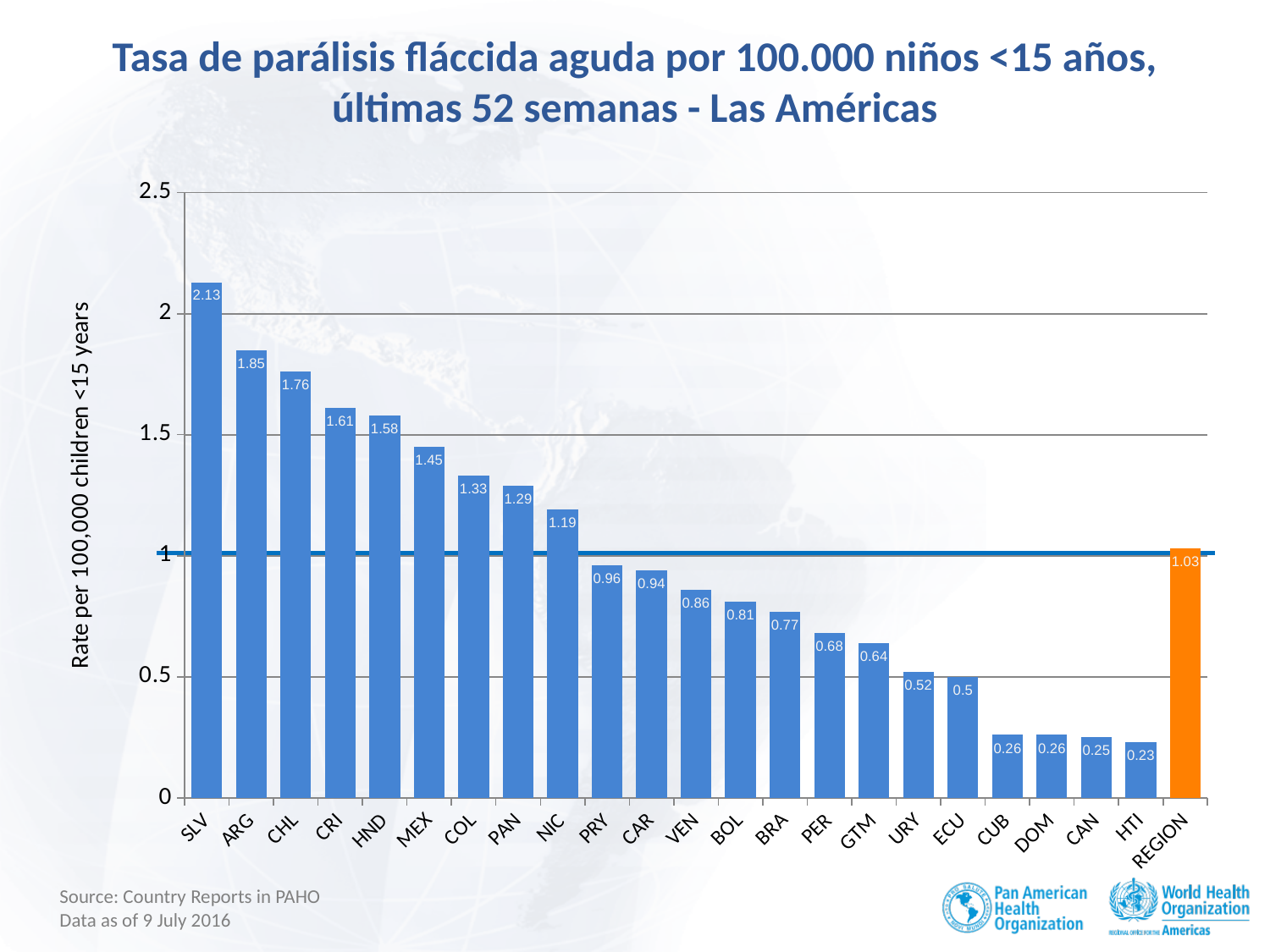
Which is larger, the value for PRY or the value for VEN? PRY Which bar is coloured orange instead of blue? REGION How many bars are plotted in the chart? 23 Which category has the highest value? SLV What is the value for MEX? 1.45 Which category has the lowest value? HTI What is the value for ECU? 0.5 Is the value for NIC greater or less than 1? greater What is the value for the REGION bar? 1.03 What kind of chart is shown on the slide? Bar chart What is the difference between the values for ARG and CHL? 0.09 What is the value for SLV? 2.13